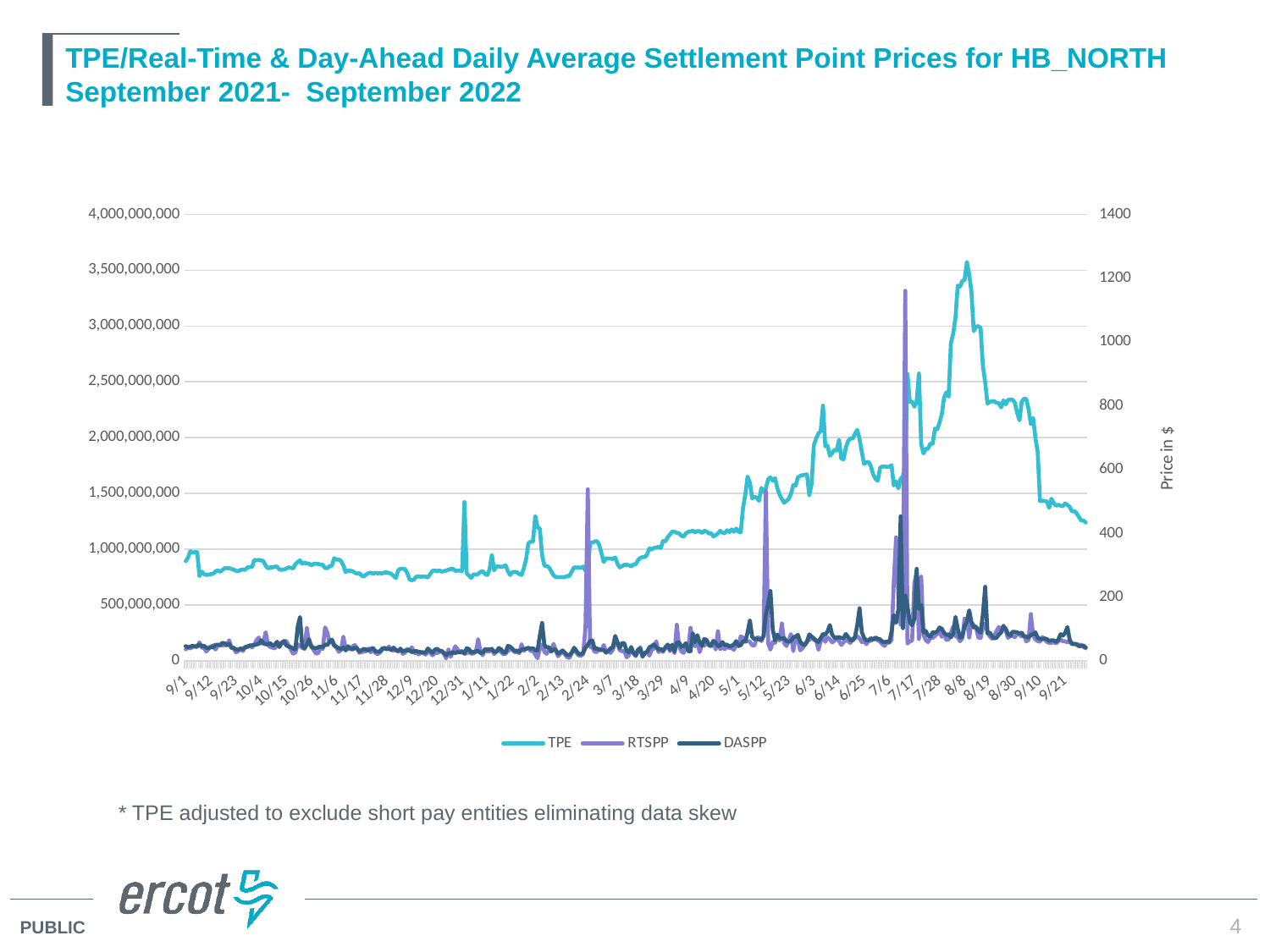
How many series does the legend list? 3 Is the highest spike of the RTSPP line (around 7/17) greater or less than 1000 on the right axis? greater Is the TPE value around 8/8 larger or smaller than the TPE value around 9/1? larger Is the TPE value at the last date shown (9/21) greater or less than 1,000,000,000 on the left axis? greater What kind of chart is shown on the slide? Line chart Does the TPE line generally rise or fall between 8/8 and 9/21? fall Is the peak value of the TPE line (around 8/8) greater or less than 3,000,000,000 on the left axis? greater Does the TPE line generally rise or fall between 5/1 and 8/8? rise What is the title of the right-hand vertical axis? Price in $ Which series reaches a higher peak on the right-hand price axis, RTSPP or DASPP? RTSPP What are the three series named in the legend? TPE, RTSPP, DASPP